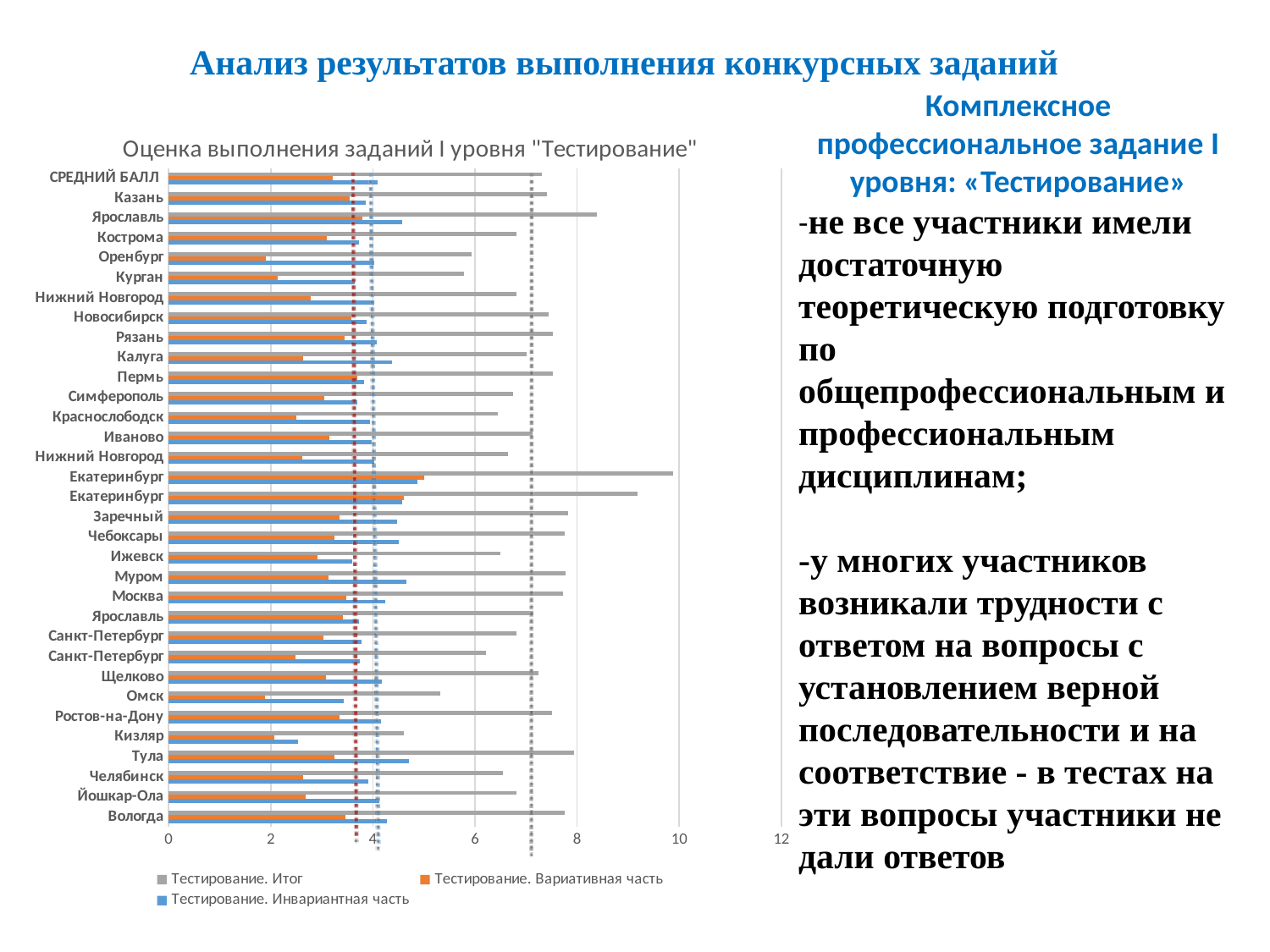
Which has the larger "Тестирование. Итог" value, Казань or Омск? Казань Is the "Тестирование. Вариативная часть" value for Нижний Новгород (the first one listed) greater or less than 4? less Which has the larger "Тестирование. Вариативная часть" value, Екатеринбург or Оренбург? Екатеринбург Is the "Тестирование. Итог" value for Казань greater or less than 6? greater Is the "Тестирование. Инвариантная часть" value for Тула greater or less than 4? greater What is the title of the chart? Оценка выполнения заданий I уровня "Тестирование" Which category has the lowest value for "Тестирование. Итог"? Кизляр Which colour represents the series "Тестирование. Итог" in the chart? gray How many series does the chart legend list? 3 Which category has the highest value for "Тестирование. Итог"? Екатеринбург What kind of chart is shown on the slide? bar chart